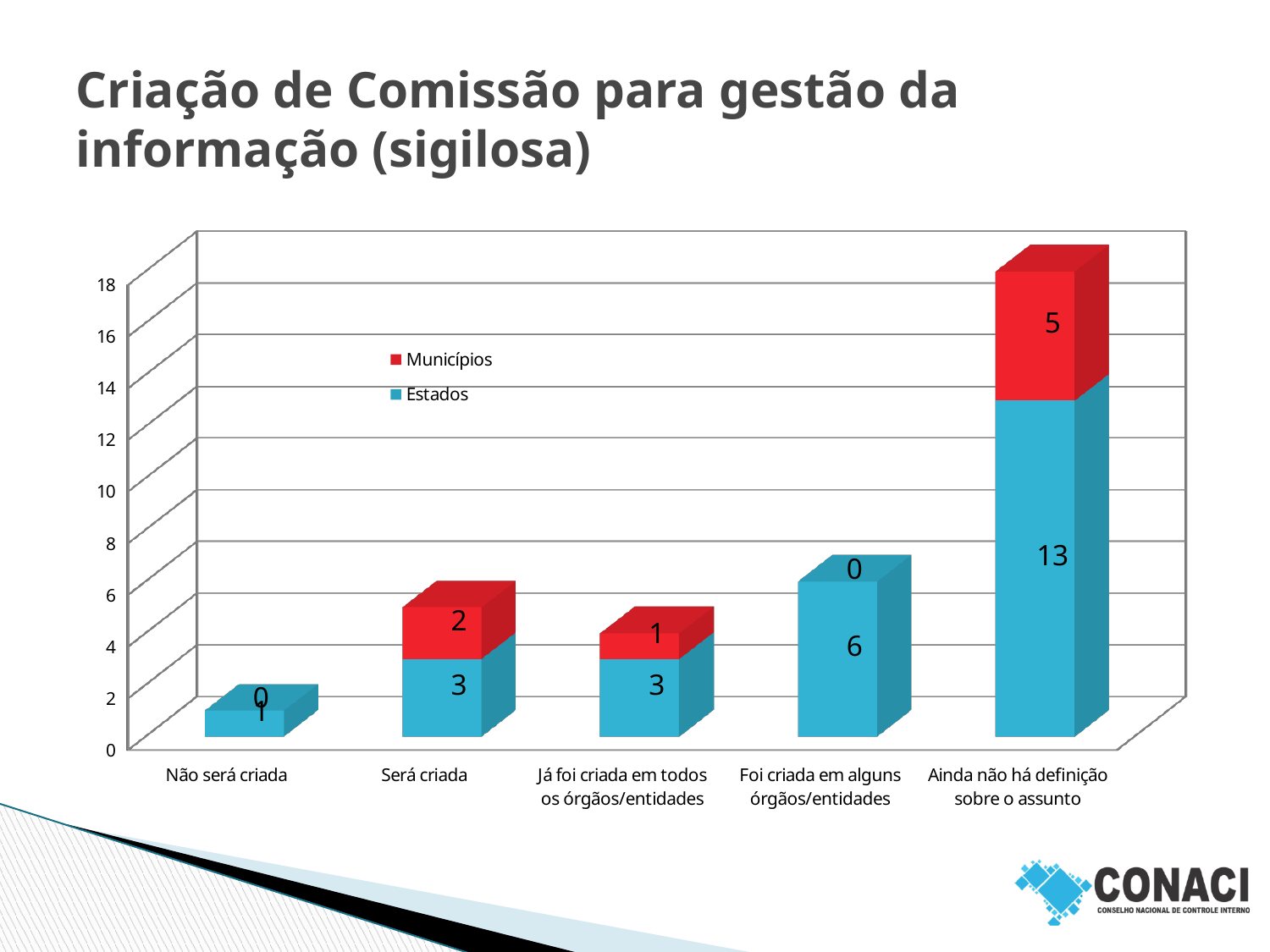
How many categories are shown on the x axis? 5 Which series is shown in red in the legend? Municípios Which category has the highest Estados value? Ainda não há definição sobre o assunto What kind of chart is shown on the slide? Stacked bar chart What is the Municípios value for "Já foi criada em todos os órgãos/entidades"? 1 Which category has the lowest Estados value? Não será criada What is the total of the stacked bar for "Ainda não há definição sobre o assunto"? 18 How many series does the legend list? 2 What is the Estados value for "Foi criada em alguns órgãos/entidades"? 6 What is the Estados value for "Ainda não há definição sobre o assunto"? 13 What is the Municípios value for "Será criada"? 2 What is the difference between the Estados values for "Ainda não há definição sobre o assunto" and "Foi criada em alguns órgãos/entidades"? 7